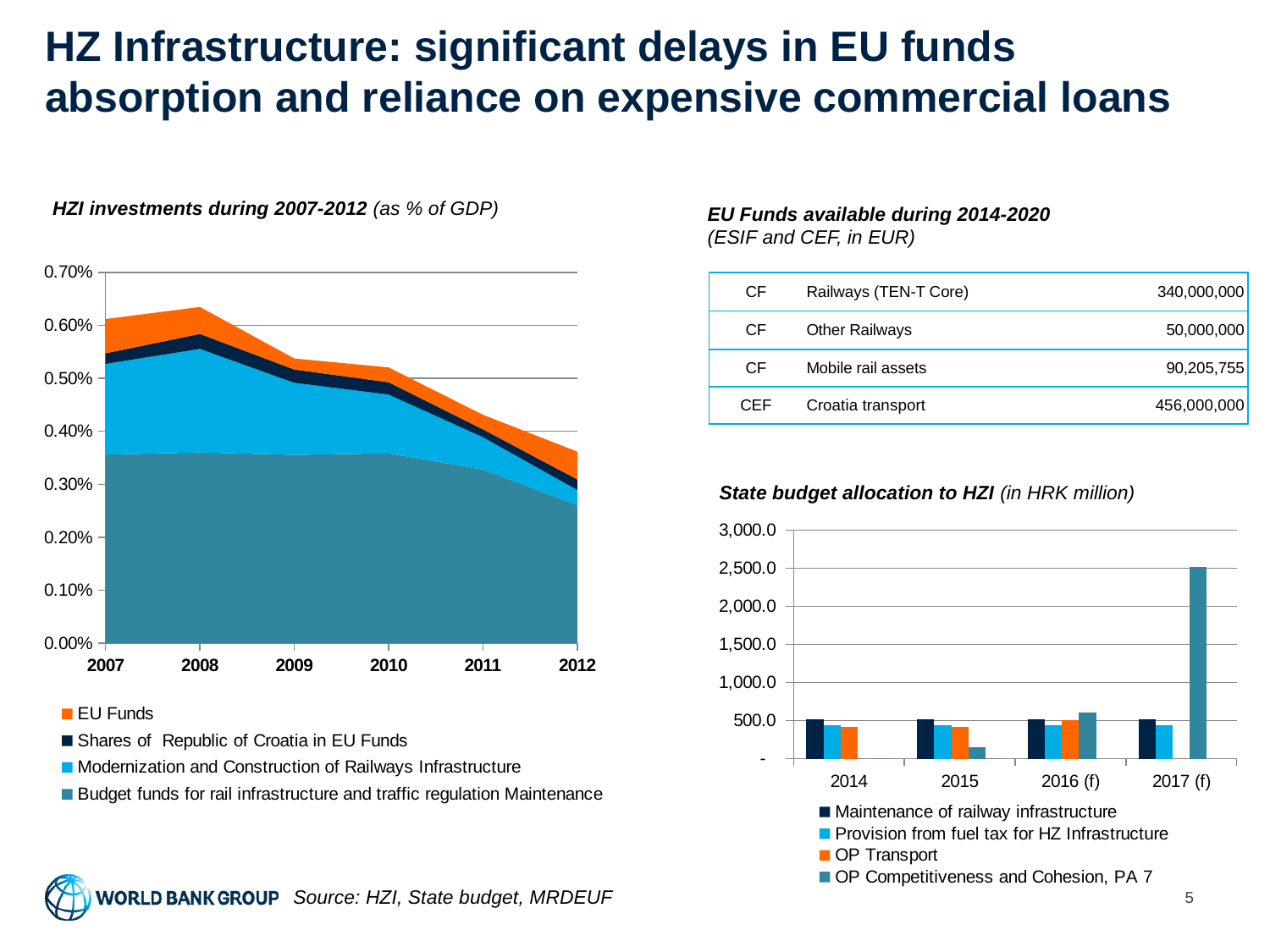
How many years are shown on the x axis of the 'HZI investments during 2007-2012' chart? 6 In the 'HZI investments during 2007-2012' chart, does the total investment as % of GDP rise or fall between 2008 and 2012? fall In the 'State budget allocation to HZI' chart, how many series does the legend list? 4 In the 'HZI investments during 2007-2012' chart, is the value for 'Budget funds for rail infrastructure and traffic regulation Maintenance' in 2007 greater or less than 0.30%? greater In the 'State budget allocation to HZI' chart, which is larger: 'OP Competitiveness and Cohesion, PA 7' in 2015 or in 2016 (f)? 2016 (f) How many categories are shown on the x axis of the 'State budget allocation to HZI' chart? 4 In the 'HZI investments during 2007-2012' chart, is the total investment in 2012 greater or less than 0.40%? less In the 'State budget allocation to HZI' chart, is the value for 'OP Competitiveness and Cohesion, PA 7' in 2017 (f) greater or less than 2,000.0? greater What kind of chart is 'HZI investments during 2007-2012 (as % of GDP)'? stacked area chart What kind of chart is 'State budget allocation to HZI (in HRK million)'? bar chart In the 'HZI investments during 2007-2012' chart, how many series does the legend list? 4 In the 'State budget allocation to HZI' chart, which series and year has the highest bar? OP Competitiveness and Cohesion, PA 7 in 2017 (f)